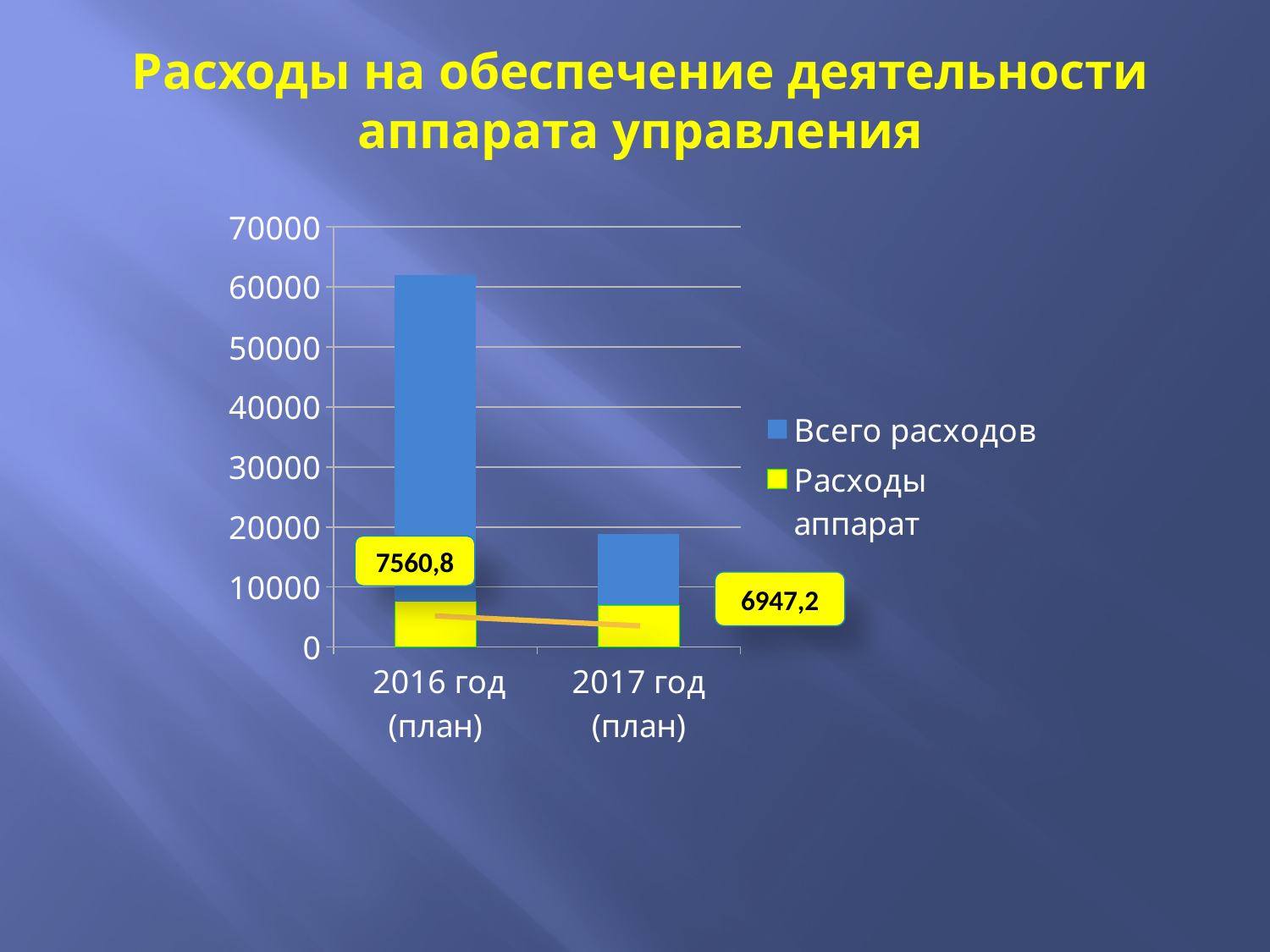
What kind of chart is shown on the slide? bar chart Which category has the highest Всего расходов bar? 2016 год (план) Which year has the higher Расходы аппарат value, 2016 год (план) or 2017 год (план)? 2016 год (план) Is the Всего расходов bar for 2017 год (план) greater or less than 30000? less What is the value of Расходы аппарат for 2016 год (план)? 7560,8 How many series does the legend list? 2 What colour represents the Всего расходов series in the legend? blue What is the difference between the Расходы аппарат values for 2016 год (план) and 2017 год (план)? 613,6 Do the Расходы аппарат values rise or fall from 2016 год (план) to 2017 год (план)? fall What is the value of Расходы аппарат for 2017 год (план)? 6947,2 Is the Всего расходов bar for 2016 год (план) greater or less than 50000? greater How many categories are shown on the x axis? 2